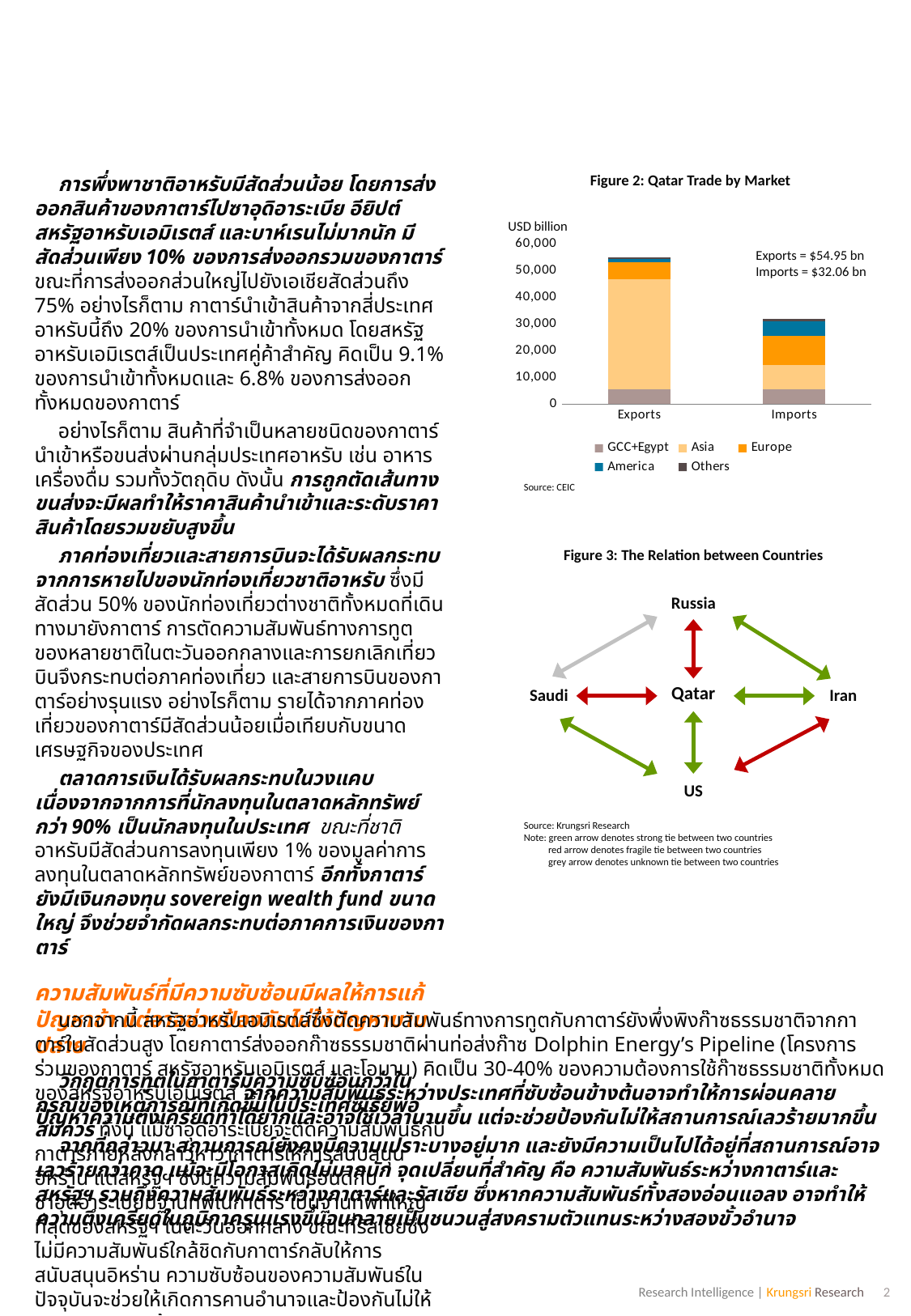
In Figure 2: Qatar Trade by Market, what is the difference between the annotated Exports and Imports totals? $22.89 bn In Figure 2: Qatar Trade by Market, which is larger, Exports or Imports? Exports In Figure 2: Qatar Trade by Market, which series makes up the largest segment of the Exports bar? Asia In Figure 2: Qatar Trade by Market, what is the total value of Imports as annotated on the chart? $32.06 bn In Figure 2: Qatar Trade by Market, what is the source cited below the chart? CEIC In Figure 2: Qatar Trade by Market, what kind of chart is shown? Stacked bar chart In Figure 2: Qatar Trade by Market, is the total Imports bar greater or less than 40,000? less In Figure 2: Qatar Trade by Market, what is the total value of Exports as annotated on the chart? $54.95 bn In Figure 2: Qatar Trade by Market, what unit is shown on the y axis? USD billion In Figure 2: Qatar Trade by Market, is the total Exports bar greater or less than 50,000? greater In Figure 2: Qatar Trade by Market, how many categories are shown on the x axis? 2 In Figure 2: Qatar Trade by Market, how many series does the legend list? 5